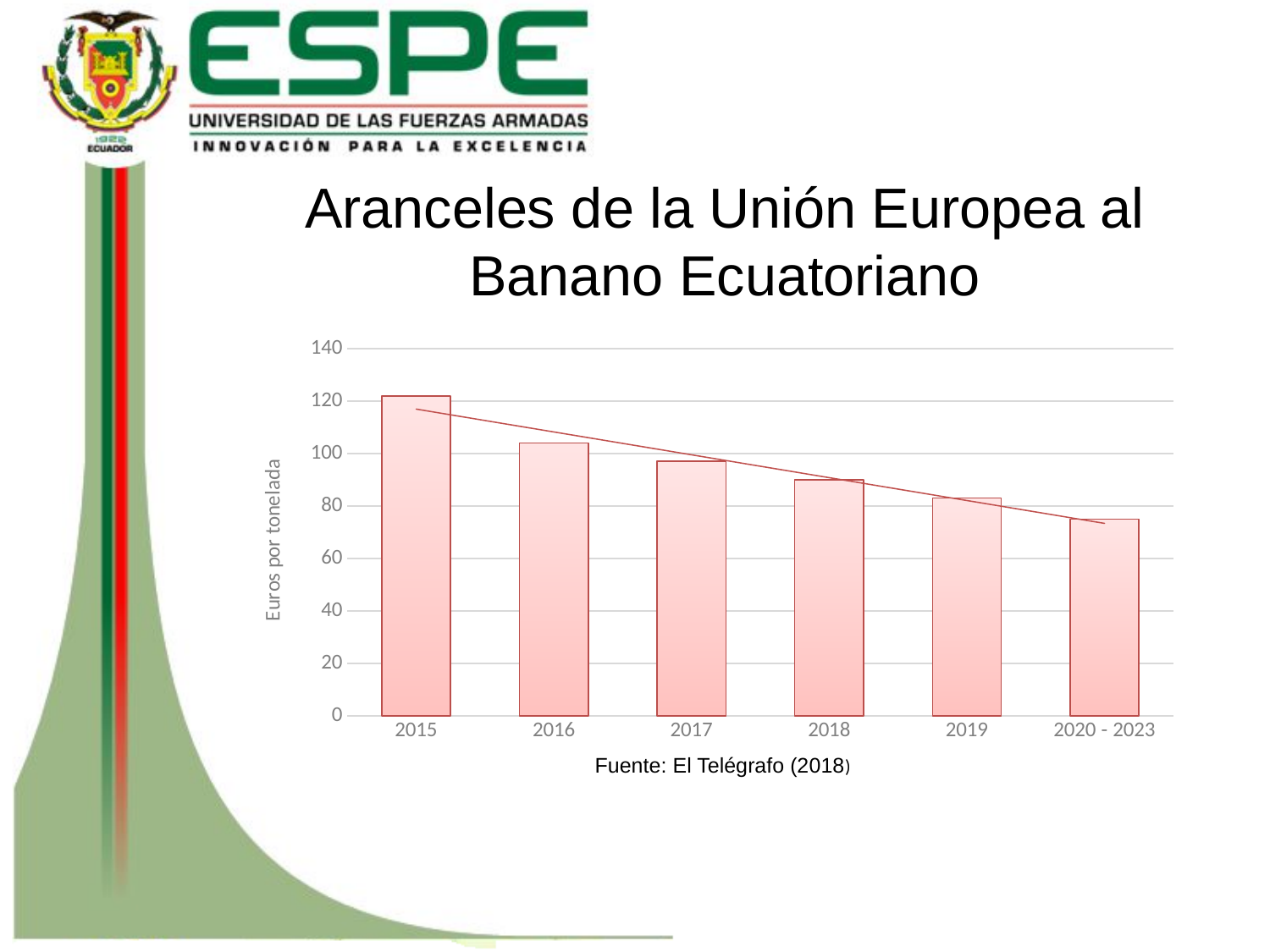
What kind of chart is shown on the slide? bar chart What is the label of the vertical axis of the chart? Euros por tonelada Do the values rise or fall from 2015 to 2020 - 2023? fall Is the value for 2015 greater or less than 100? greater How many categories are shown on the x axis of the chart? 6 Which category has the highest value in the chart? 2015 Which is larger, the value for 2016 or the value for 2019? 2016 Is the value for 2018 greater or less than 100? less Which category has the lowest value in the chart? 2020 - 2023 Which is larger, the value for 2015 or the value for 2018? 2015 Is the value for 2020 - 2023 greater or less than 80? less What is the title of the chart on the slide? Aranceles de la Unión Europea al Banano Ecuatoriano